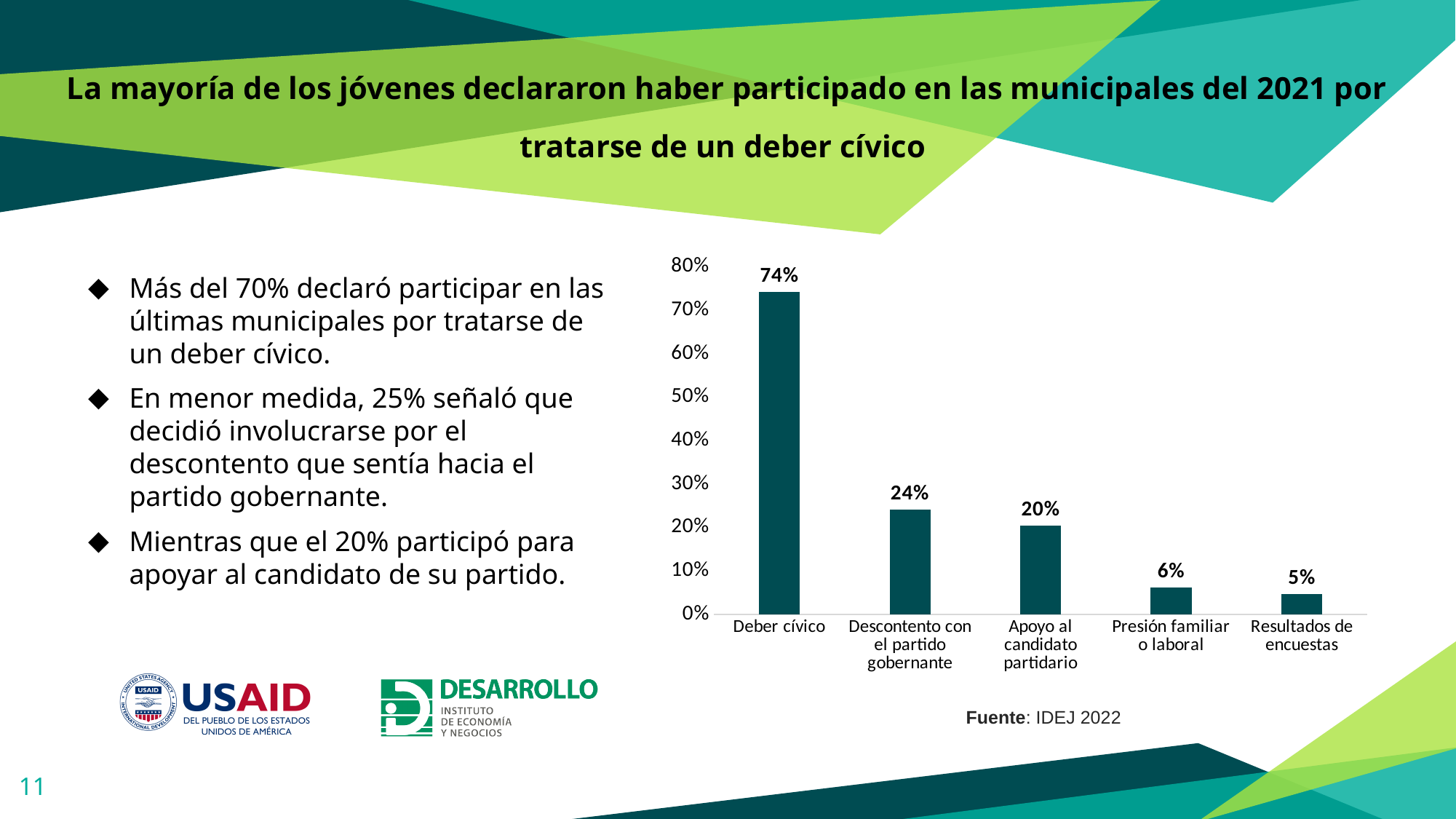
Which category has the lowest value? Resultados de encuestas What is the value for Resultados de encuestas? 5% What kind of chart is shown on the slide? Bar chart Which is larger, the value for Apoyo al candidato partidario or the value for Presión familiar o laboral? Apoyo al candidato partidario Which category has the highest value? Deber cívico What is the difference between the values for Deber cívico and Descontento con el partido gobernante? 50% What is the value for Deber cívico? 74% What is the value for Apoyo al candidato partidario? 20% What source is cited below the chart? IDEJ 2022 What is the value for Presión familiar o laboral? 6% What is the value for Descontento con el partido gobernante? 24% How many categories are shown in the chart? 5